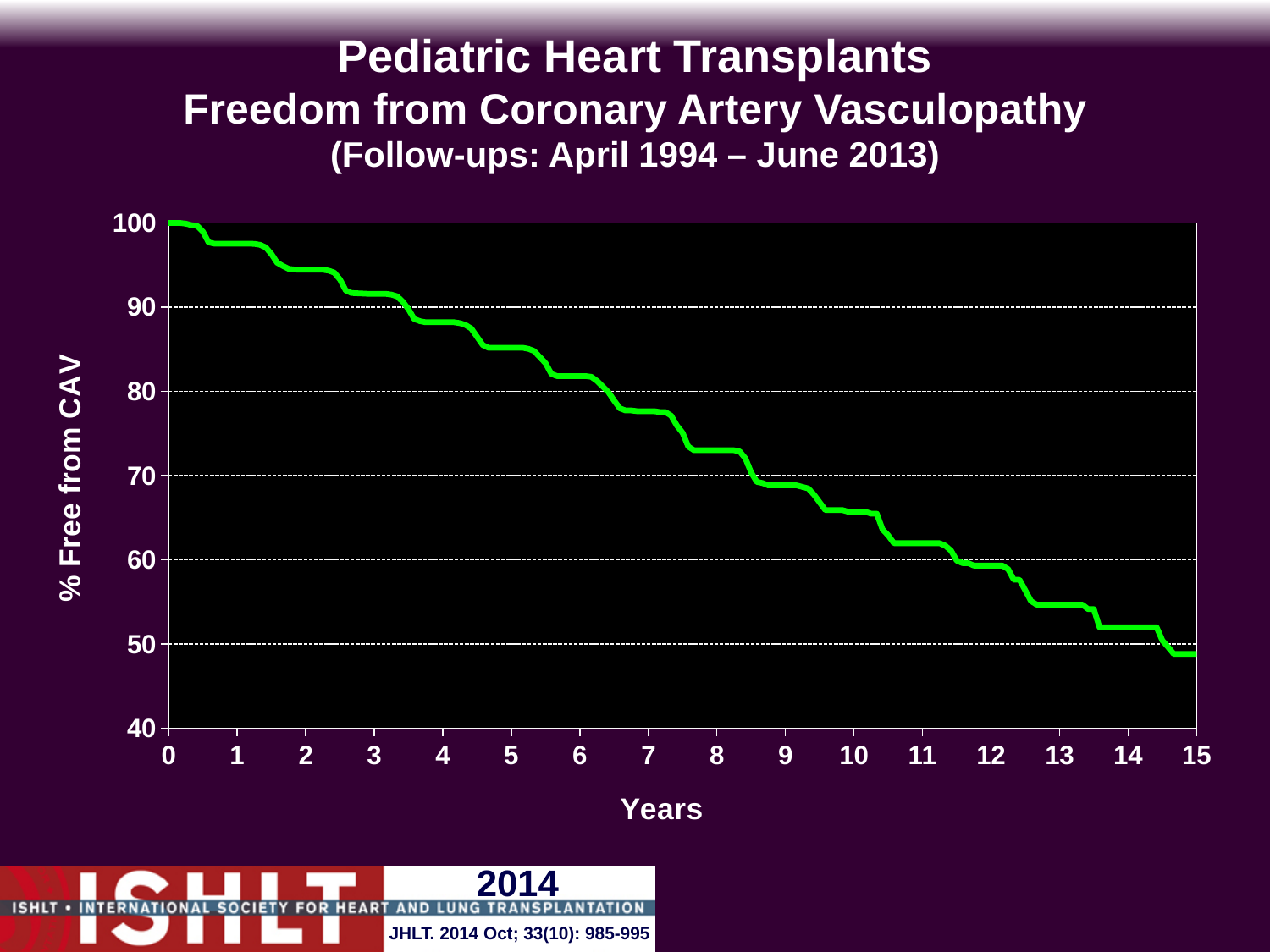
Is the % free from CAV at year 10 greater or less than 70? less Is the % free from CAV at year 7 greater or less than 80? less Which is larger, the % free from CAV at year 5 or at year 10? year 5 What kind of chart is shown on the slide? line chart What is the % free from CAV at year 0? 100 Is the % free from CAV at year 15 greater or less than 50? less What is the label of the x axis? Years Does the % free from CAV rise or fall as the years increase? fall What is the label of the y axis? % Free from CAV